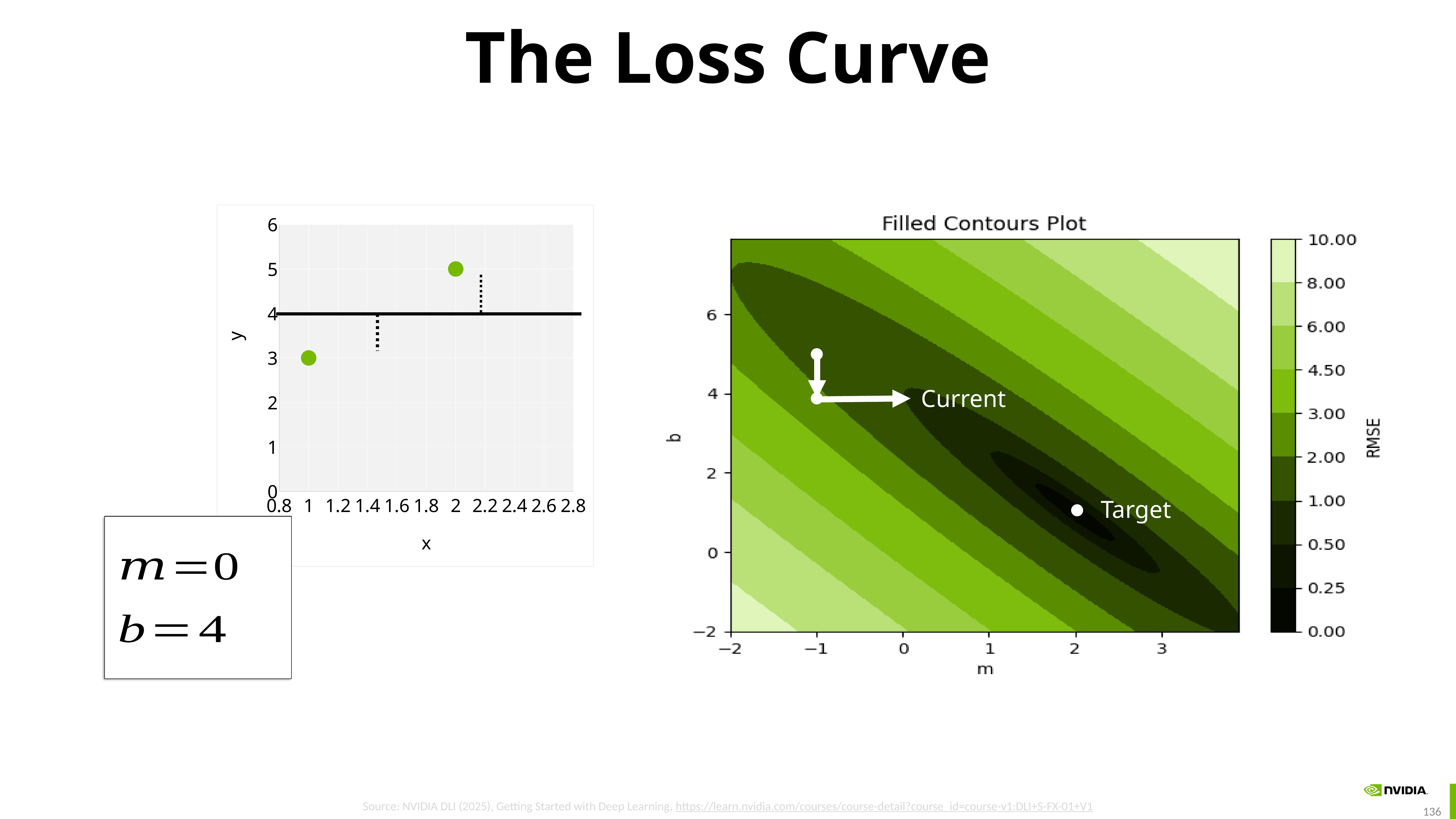
In the left chart, what is the y value of the point at x = 2? 5 In the left chart, how many data points are plotted? 2 In the left chart, what is the y value of the point at x = 1? 3 What is the title of the chart on the right? Filled Contours Plot In the Filled Contours Plot, is the b value of the Target point greater or less than 2? less What kind of chart is the left chart with axes x and y? scatter plot In the left chart, which point has the higher y value, the one at x = 1 or the one at x = 2? x = 2 In the Filled Contours Plot, what quantity does the colour bar represent? RMSE In the left chart, at what y value is the horizontal black line drawn? 4 In the Filled Contours Plot, what is the highest value shown on the colour bar? 10.00 In the left chart, what is the difference in y between the point at x = 2 and the point at x = 1? 2 In the Filled Contours Plot, is the m value of the Current point greater or less than 0? less